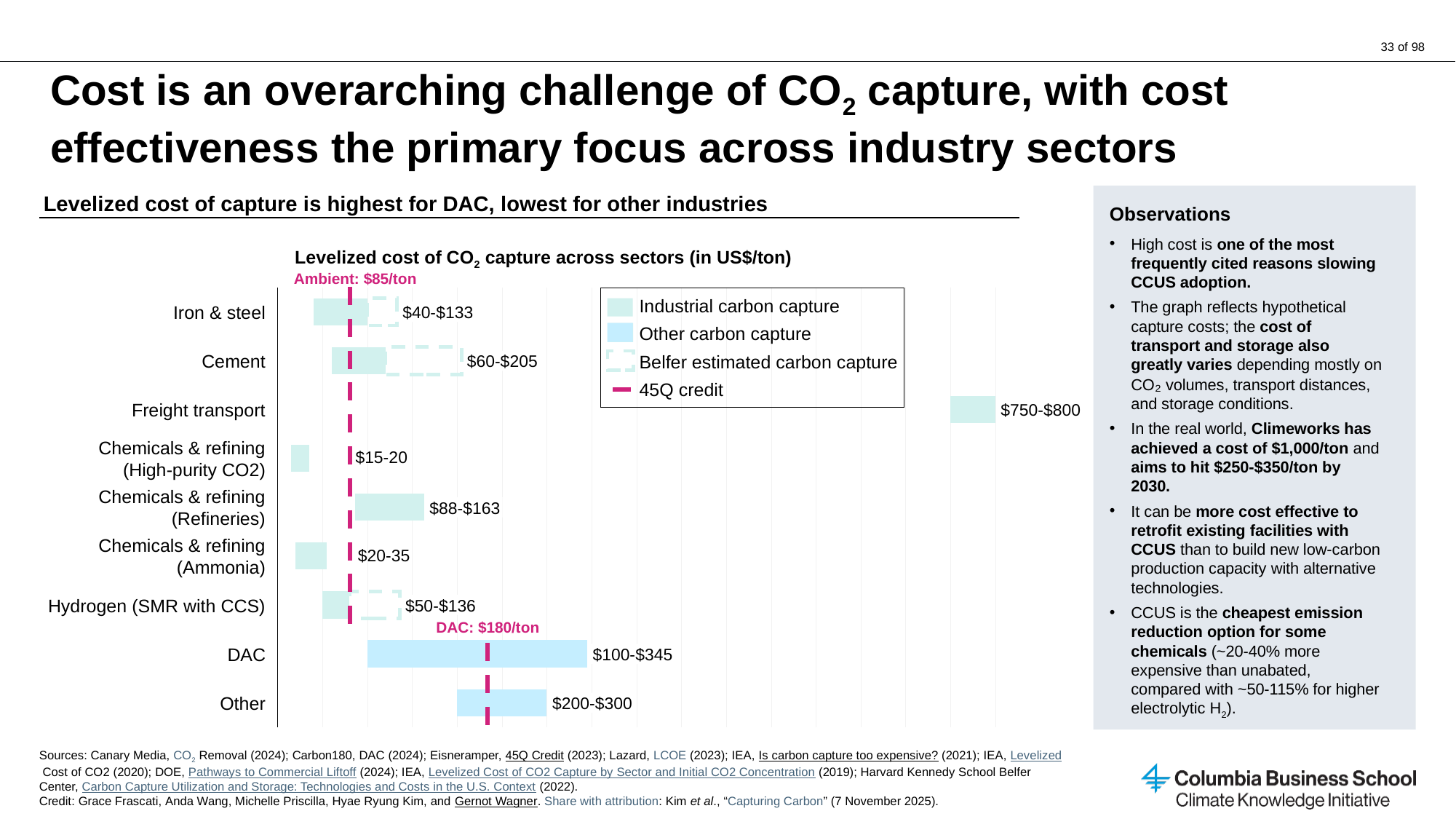
What 45Q credit value is shown for DAC? $180/ton What is the levelized cost range shown for Iron & steel? $40-$133 What is the levelized cost range shown for Chemicals & refining (Ammonia)? $20-35 How many sectors are listed on the chart? 9 What is the levelized cost range shown for DAC? $100-$345 What type of chart is used to show the levelized cost of CO2 capture across sectors? Bar chart Which sector has the highest levelized cost of CO2 capture? Freight transport What is the levelized cost range shown for Freight transport? $750-$800 What is the levelized cost range shown for Cement? $60-$205 What 45Q credit value is shown for ambient capture? $85/ton How many entries does the chart legend list? 4 Which sector has the lowest levelized cost of CO2 capture? Chemicals & refining (High-purity CO2)